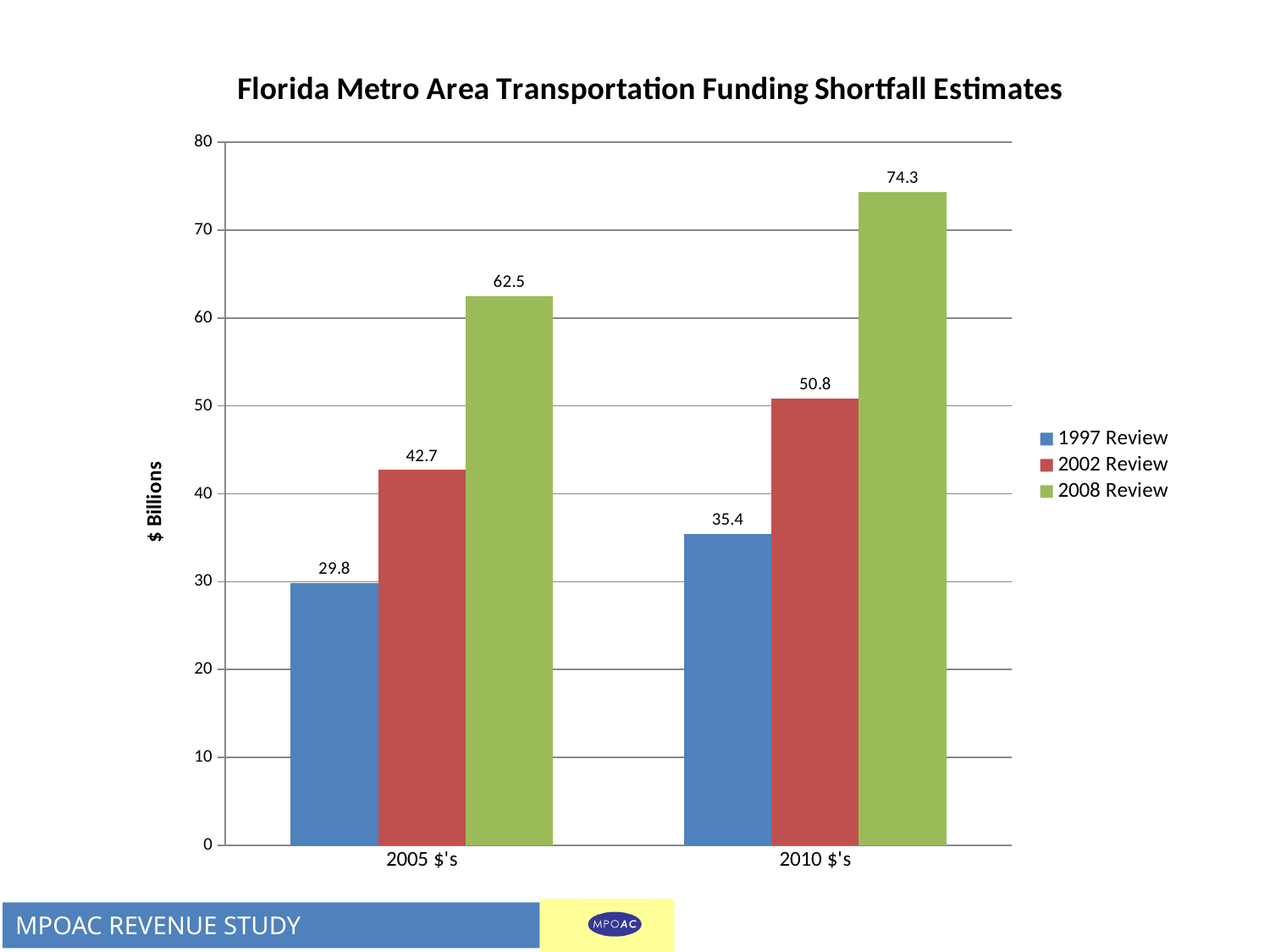
What is the difference between the 2008 Review values for 2010 $'s and 2005 $'s? 11.8 How many series does the legend list? 3 What kind of chart is shown on the slide? bar chart What is the title of the chart? Florida Metro Area Transportation Funding Shortfall Estimates Which series has the lowest value for 2010 $'s? 1997 Review What is the 2008 Review value for 2010 $'s? 74.3 What is the difference between the 2002 Review and 1997 Review values for 2005 $'s? 12.9 What is the 1997 Review value for 2005 $'s? 29.8 Which is larger: the 2002 Review value for 2010 $'s or the 2008 Review value for 2005 $'s? 2008 Review value for 2005 $'s Which series has the highest value for 2005 $'s? 2008 Review Is the 1997 Review value for 2010 $'s greater or less than 40? less What is the 2002 Review value for 2010 $'s? 50.8